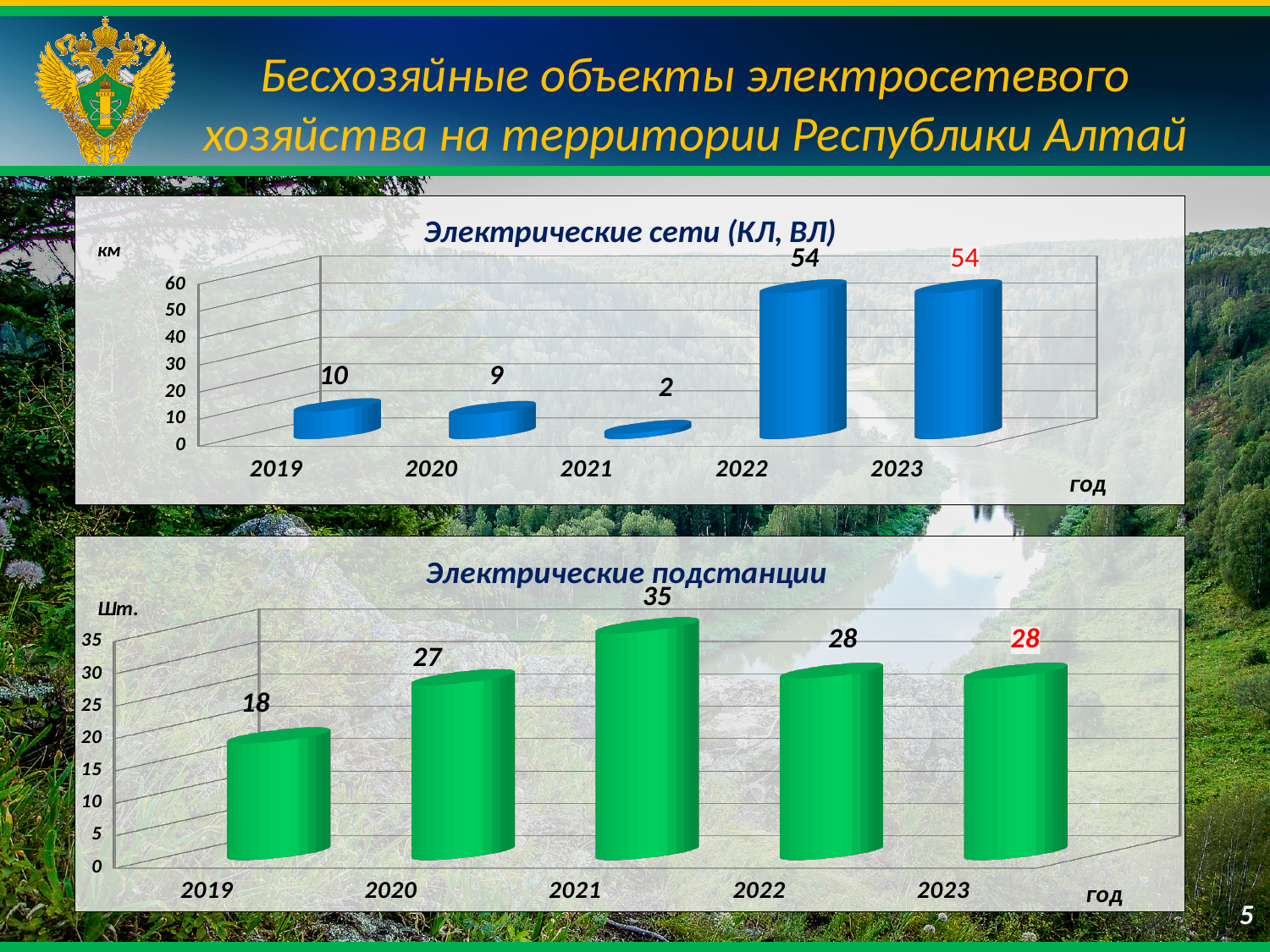
In the chart titled 'Электрические подстанции', do the values rise or fall from 2019 to 2021? rise What kind of chart is the chart titled 'Электрические подстанции'? bar chart In the chart titled 'Электрические сети (КЛ, ВЛ)', what is the difference between the values for 2019 and 2020? 1 In the chart titled 'Электрические сети (КЛ, ВЛ)', how many years are shown on the x axis? 5 In the chart titled 'Электрические подстанции', which is larger, the value for 2020 or the value for 2022? 2022 In the chart titled 'Электрические подстанции', what is the difference between the values for 2021 and 2022? 7 In the chart titled 'Электрические подстанции', which year has the highest value? 2021 In the chart titled 'Электрические сети (КЛ, ВЛ)', which year has the lowest value? 2021 In the chart titled 'Электрические подстанции', what is the value for 2019? 18 In the chart titled 'Электрические сети (КЛ, ВЛ)', what is the value for 2022? 54 In the chart titled 'Электрические сети (КЛ, ВЛ)', what unit is shown on the vertical axis? км In the chart titled 'Электрические сети (КЛ, ВЛ)', what is the value for 2021? 2